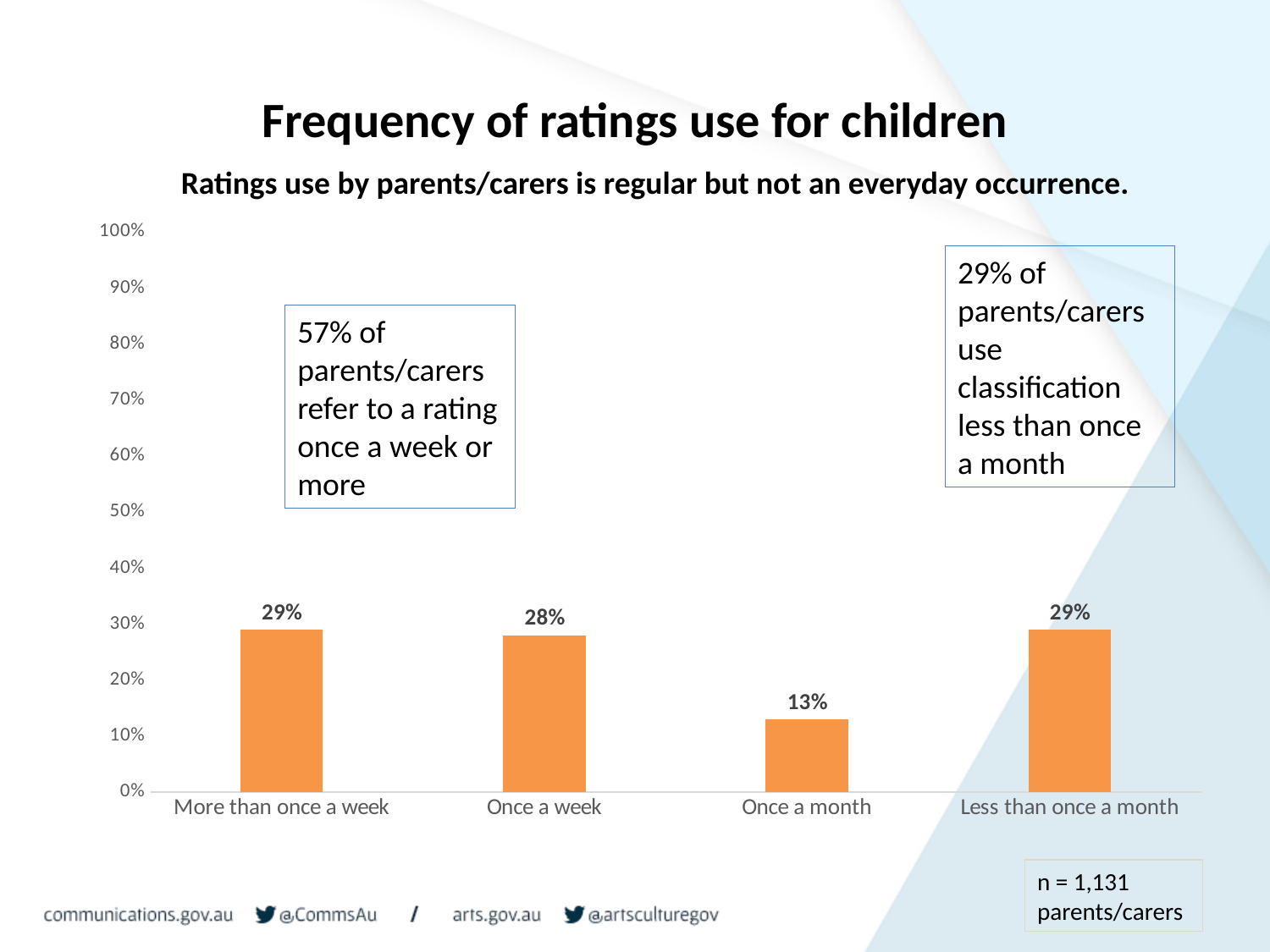
Which category has the lowest value? Once a month How many categories are shown on the x axis? 4 Which is larger, the value for "Once a week" or the value for "Once a month"? Once a week What is the difference between the values for "Once a week" and "Once a month"? 15% What is the value for "More than once a week"? 29% What is the sample size (n) stated on the slide? n = 1,131 parents/carers What is the title of the chart? Frequency of ratings use for children Is the value for "Less than once a month" greater or less than 20%? greater What is the value for "Once a week"? 28% What kind of chart is shown on the slide? Bar chart What is the value for "Once a month"? 13% Is the value for "Once a month" greater or less than 20%? less